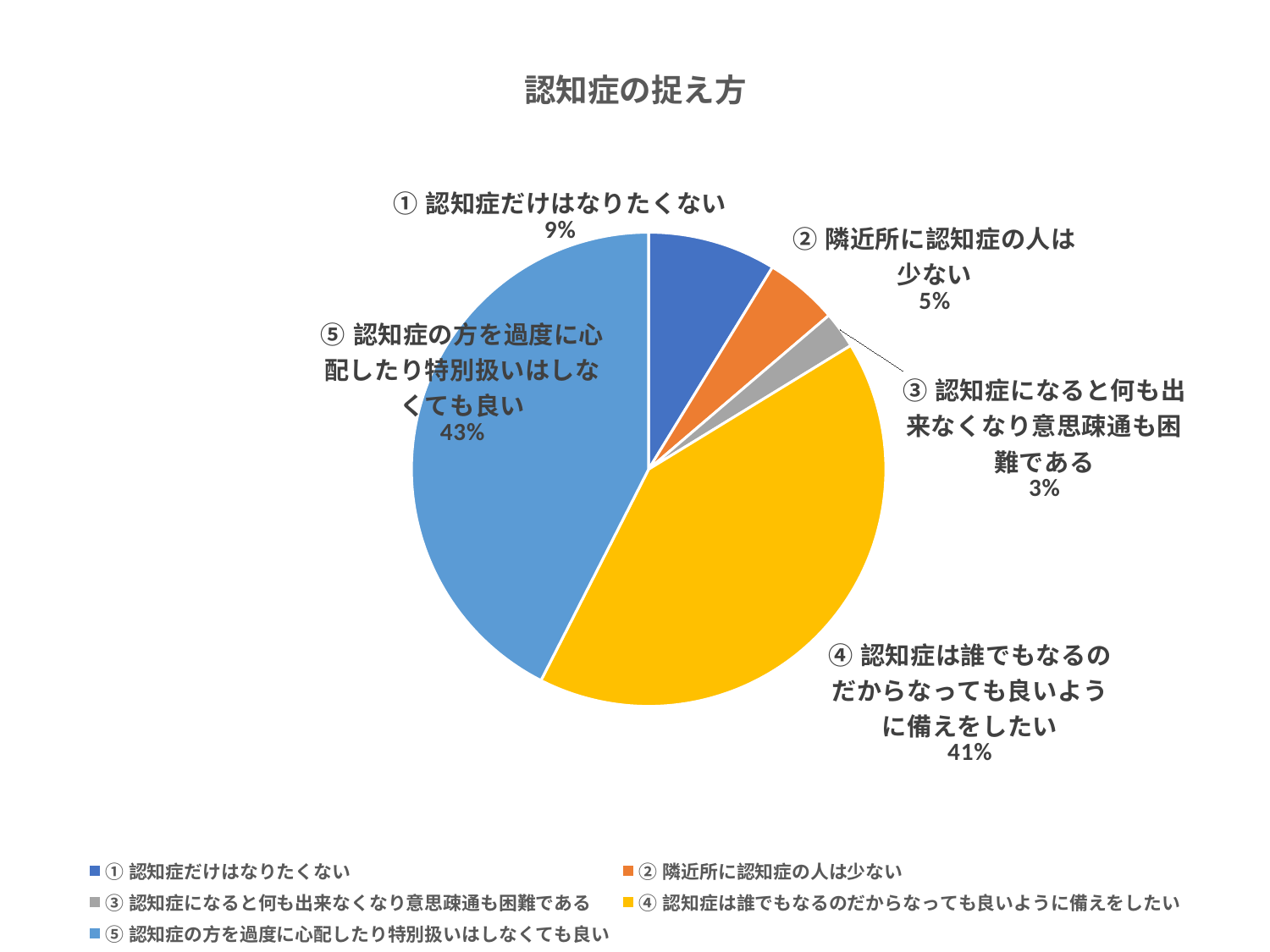
What kind of chart is shown on the slide? pie chart What share of the pie does ⑤ 認知症の方を過度に心配したり特別扱いはしなくても良い have? 43% What share of the pie does ③ 認知症になると何も出来なくなり意思疎通も困難である have? 3% What is the chart's title? 認知症の捉え方 What share of the pie does ① 認知症だけはなりたくない have? 9% What is the difference in percentage points between ⑤ 認知症の方を過度に心配したり特別扱いはしなくても良い and ④ 認知症は誰でもなるのだからなっても良いように備えをしたい? 2% Which category has the largest slice? ⑤ 認知症の方を過度に心配したり特別扱いはしなくても良い Which category has the smallest slice? ③ 認知症になると何も出来なくなり意思疎通も困難である How many categories does the pie chart have? 5 Which is larger, the slice for ① 認知症だけはなりたくない or the slice for ② 隣近所に認知症の人は少ない? ① 認知症だけはなりたくない